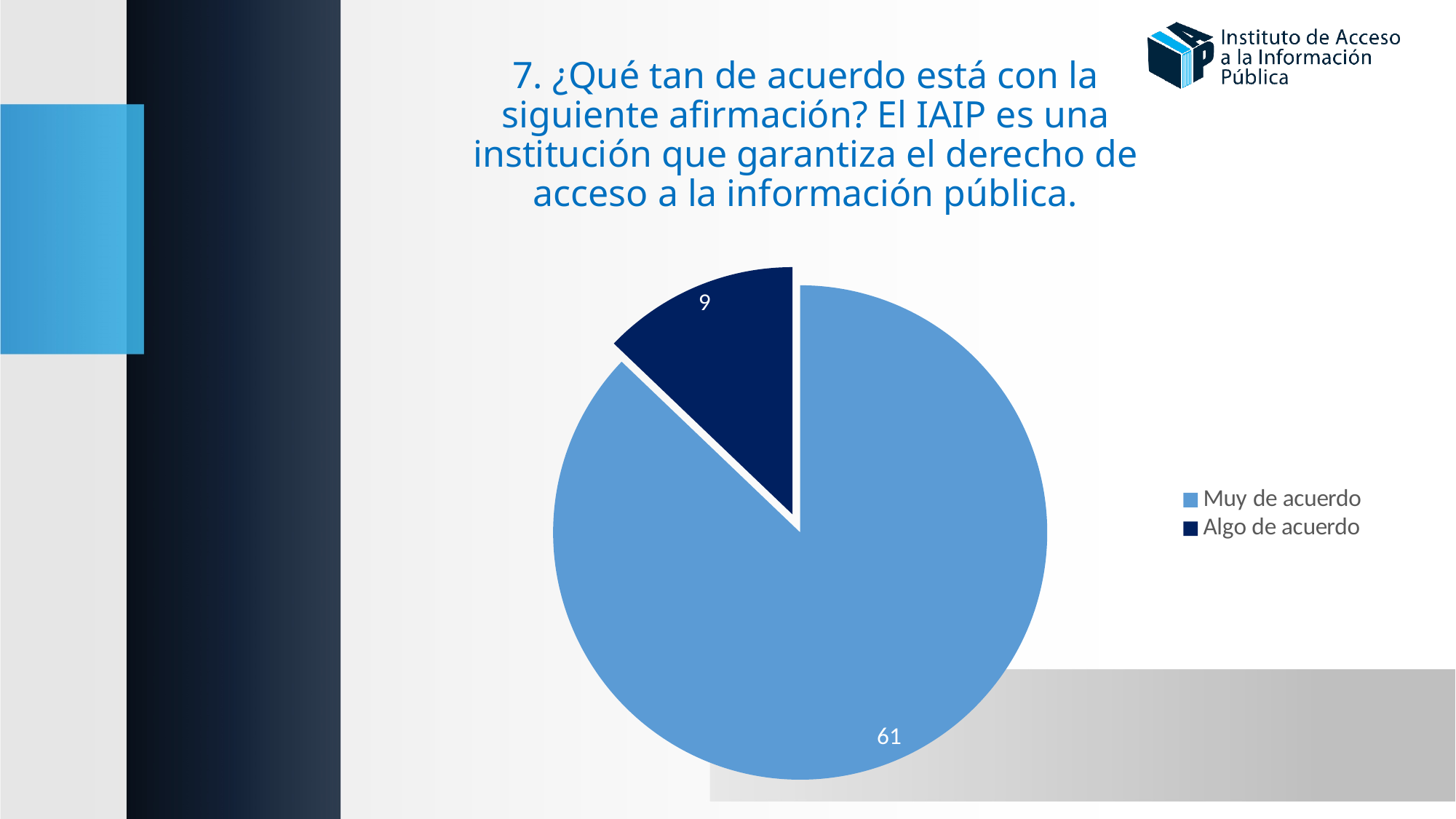
What is the difference between the Muy de acuerdo and Algo de acuerdo values? 52 Which category has the largest slice of the pie? Muy de acuerdo How many entries does the legend list? 2 Which category has the smallest slice of the pie? Algo de acuerdo How many slices does the pie chart have? 2 Which is larger, Muy de acuerdo or Algo de acuerdo? Muy de acuerdo Which colour represents Algo de acuerdo in the legend? Dark blue What kind of chart is shown on the slide? Pie chart What is the total of all slices in the pie chart? 70 What value is shown for the Muy de acuerdo slice? 61 What value is shown for the Algo de acuerdo slice? 9 Which legend entry is shown in light blue? Muy de acuerdo